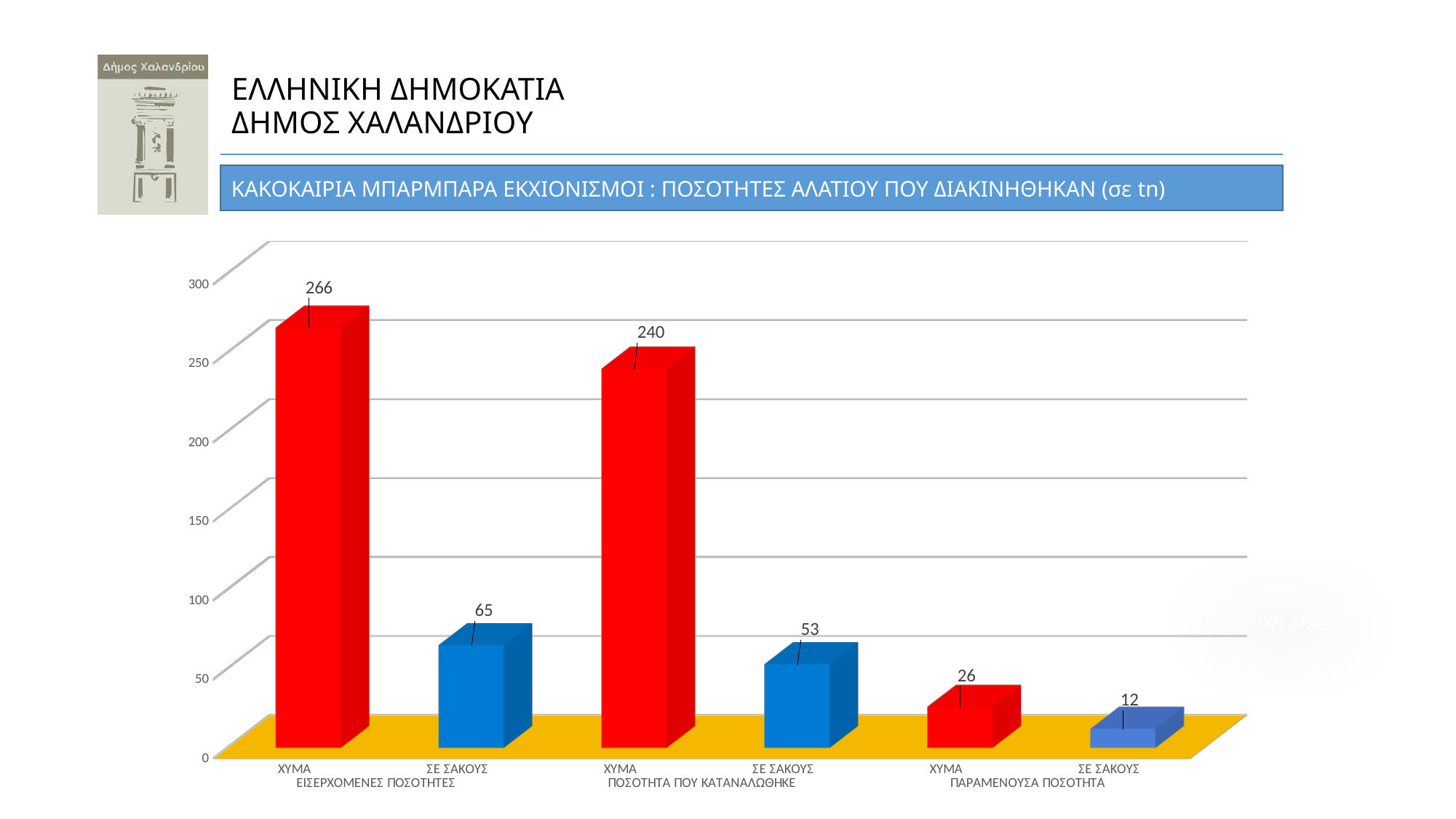
Which is larger: the ΧΥΜΑ bar under ΠΑΡΑΜΕΝΟΥΣΑ ΠΟΣΟΤΗΤΑ or the ΣΕ ΣΑΚΟΥΣ bar under ΠΟΣΟΤΗΤΑ ΠΟΥ ΚΑΤΑΝΑΛΩΘΗΚΕ? ΣΕ ΣΑΚΟΥΣ under ΠΟΣΟΤΗΤΑ ΠΟΥ ΚΑΤΑΝΑΛΩΘΗΚΕ What unit does the chart title say the quantities are in? tn What is the value of the ΣΕ ΣΑΚΟΥΣ bar under ΠΟΣΟΤΗΤΑ ΠΟΥ ΚΑΤΑΝΑΛΩΘΗΚΕ? 53 What is the value of the ΣΕ ΣΑΚΟΥΣ bar under ΠΑΡΑΜΕΝΟΥΣΑ ΠΟΣΟΤΗΤΑ? 12 How many bars are plotted on the chart? 6 Is the value of the ΧΥΜΑ bar under ΠΟΣΟΤΗΤΑ ΠΟΥ ΚΑΤΑΝΑΛΩΘΗΚΕ greater or less than 200? greater Which bar has the highest value on the chart? ΧΥΜΑ under ΕΙΣΕΡΧΟΜΕΝΕΣ ΠΟΣΟΤΗΤΕΣ What kind of chart is shown on the slide? Bar chart Which bar has the lowest value on the chart? ΣΕ ΣΑΚΟΥΣ under ΠΑΡΑΜΕΝΟΥΣΑ ΠΟΣΟΤΗΤΑ What is the value of the ΧΥΜΑ bar under ΕΙΣΕΡΧΟΜΕΝΕΣ ΠΟΣΟΤΗΤΕΣ? 266 What is the difference between the ΧΥΜΑ values for ΕΙΣΕΡΧΟΜΕΝΕΣ ΠΟΣΟΤΗΤΕΣ and ΠΟΣΟΤΗΤΑ ΠΟΥ ΚΑΤΑΝΑΛΩΘΗΚΕ? 26 What is the difference between the ΣΕ ΣΑΚΟΥΣ values for ΕΙΣΕΡΧΟΜΕΝΕΣ ΠΟΣΟΤΗΤΕΣ and ΠΟΣΟΤΗΤΑ ΠΟΥ ΚΑΤΑΝΑΛΩΘΗΚΕ? 12